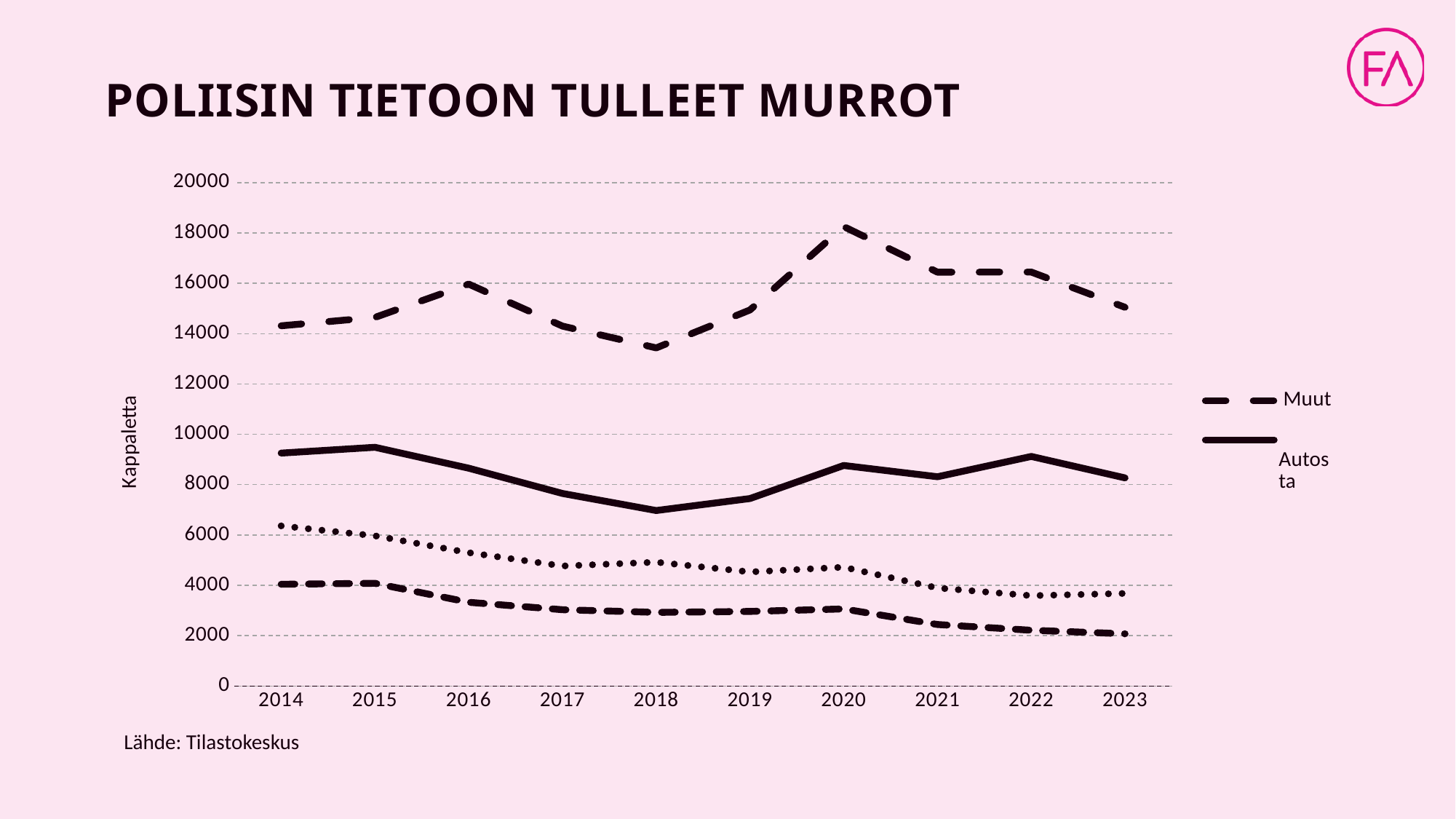
How many years are shown on the x axis? 10 Does the Autosta series rise or fall from 2015 to 2018? fall How many series does the legend list? 2 Which is larger: the Autosta value in 2014 or in 2018? 2014 Is the value for Autosta in 2018 greater or less than 8000? less In which year does the Muut series reach its highest value? 2020 In which year does the Muut series reach its lowest value? 2018 What is the label on the y axis? Kappaletta Is the value for Muut in 2020 greater or less than 16000? greater Is the value for Muut in 2018 greater or less than 14000? less What kind of chart is shown on the slide? line chart In which year does the Autosta series reach its lowest value? 2018